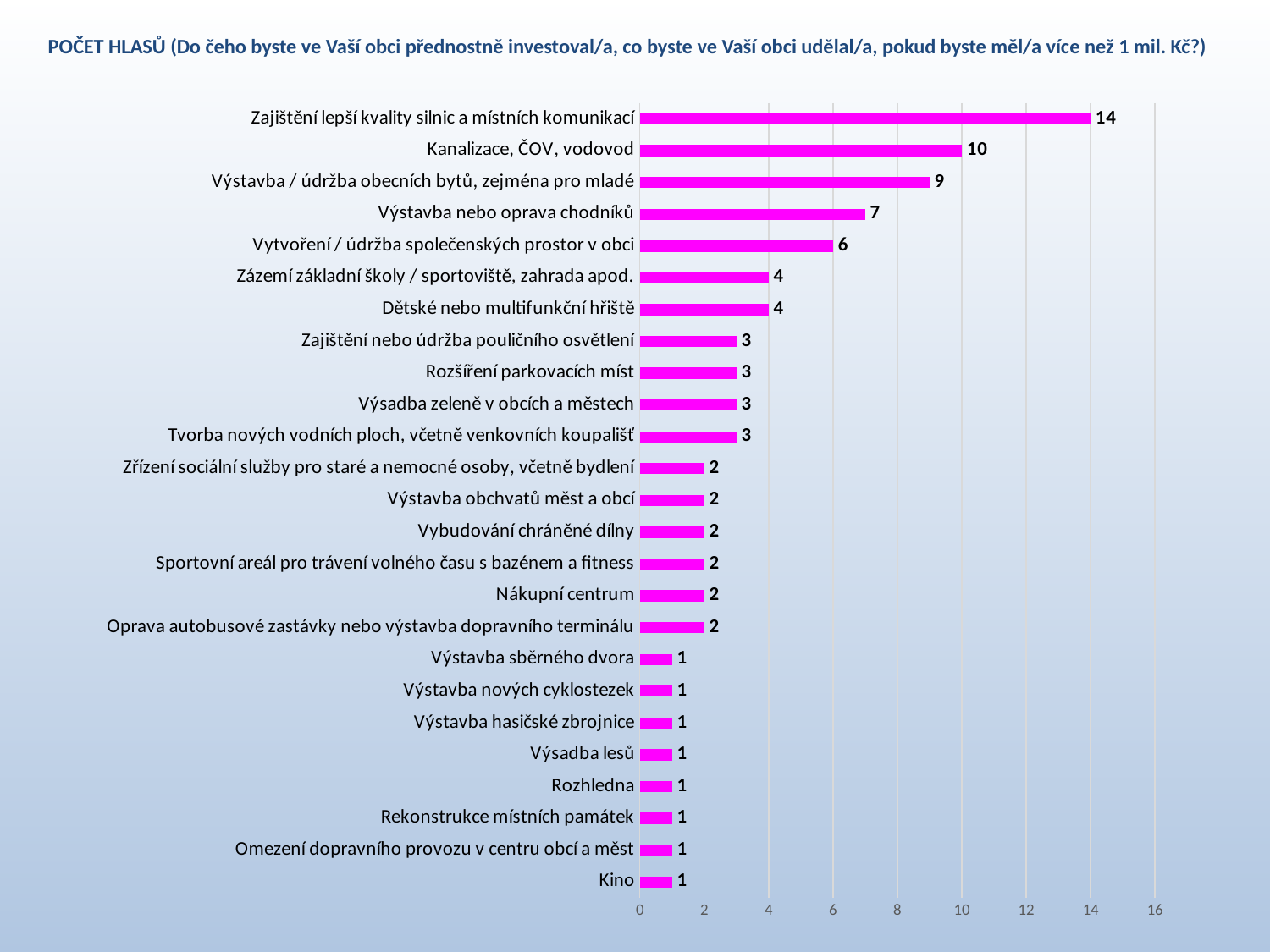
What colour are the bars in the chart? magenta Which category has the highest number of votes? Zajištění lepší kvality silnic a místních komunikací Is the value for "Kanalizace, ČOV, vodovod" greater or less than 8? greater What is the value for "Kino"? 1 What is the value for "Nákupní centrum"? 2 What is the value for "Kanalizace, ČOV, vodovod"? 10 How many votes did "Zajištění lepší kvality silnic a místních komunikací" receive? 14 How many categories are shown in the chart? 25 What type of chart is shown on the slide? bar chart What is the value for "Výstavba nebo oprava chodníků"? 7 What is the difference between the values for "Zajištění lepší kvality silnic a místních komunikací" and "Kanalizace, ČOV, vodovod"? 4 Which has a larger value: "Výstavba / údržba obecních bytů, zejména pro mladé" or "Vytvoření / údržba společenských prostor v obci"? Výstavba / údržba obecních bytů, zejména pro mladé